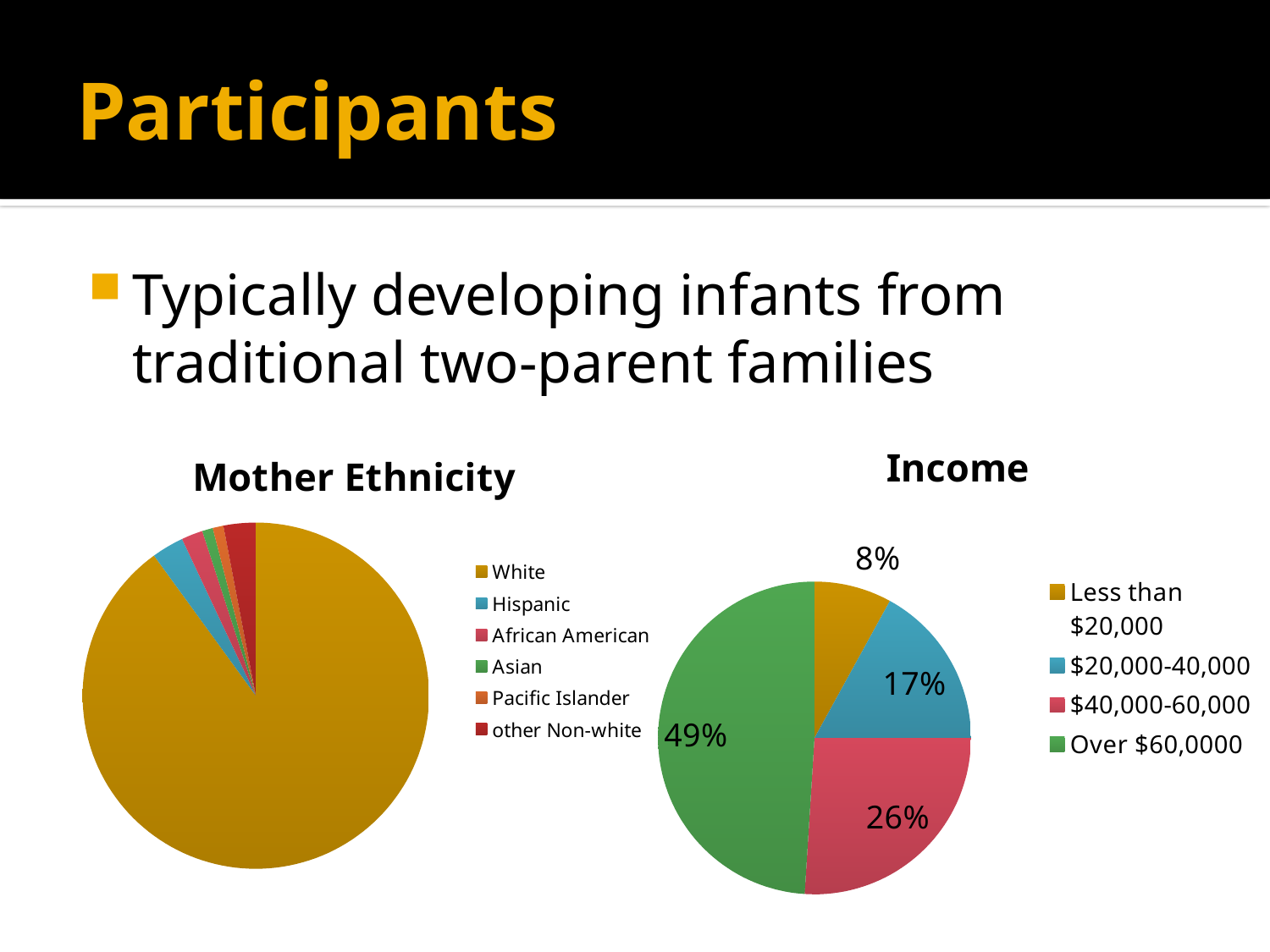
In the Income chart, what percentage of participants have an income of $20,000-40,000? 17% In the Income chart, which income category has the smallest slice? Less than $20,000 In the Income chart, what percentage of participants have an income of $40,000-60,000? 26% In the Income chart, what percentage of participants have an income of less than $20,000? 8% In the Mother Ethnicity chart, which ethnicity has the largest slice? White In the Income chart, which is larger: the $20,000-40,000 slice or the $40,000-60,000 slice? $40,000-60,000 How many income categories are shown in the Income chart? 4 What kind of chart is the Mother Ethnicity chart? Pie chart In the Income chart, what share of the pie is taken by the Over $60,0000 category? 49% In the Income chart, which income category has the largest slice? Over $60,0000 In the Income chart, how many percentage points larger is the $20,000-40,000 slice than the Less than $20,000 slice? 9 percentage points In the Income chart, how many percentage points larger is the Over $60,0000 slice than the $40,000-60,000 slice? 23 percentage points